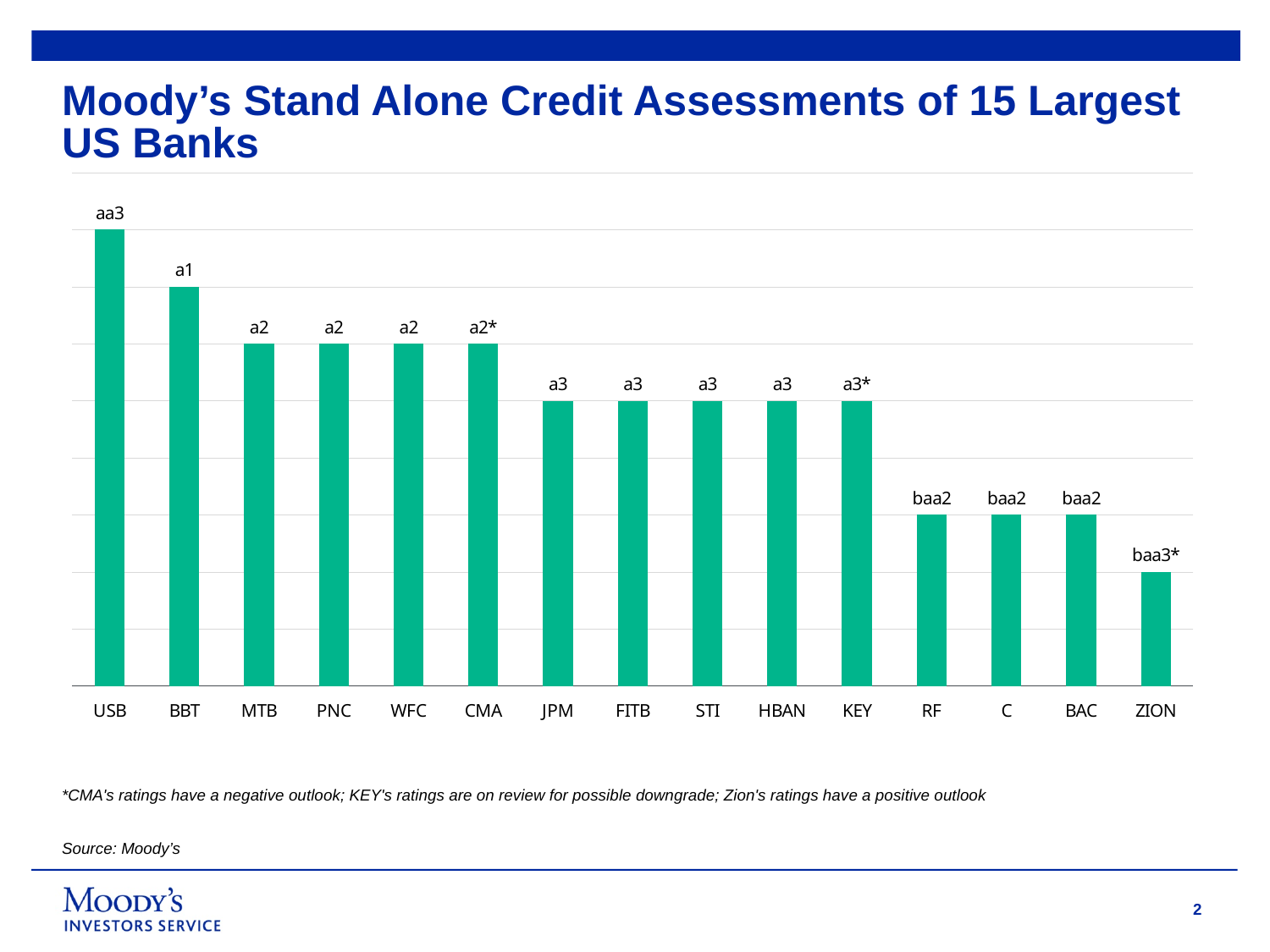
Do the bar heights rise or fall moving from left to right along the x axis? Fall Which bank has the tallest bar in the chart? USB What rating label is shown for ZION? baa3* What rating label is shown for JPM? a3 What is the Moody's stand alone credit assessment shown for USB? aa3 What rating label is shown above the bar for BBT? a1 What rating label is shown for BAC? baa2 What kind of chart is shown on the slide? Bar chart Which bank has a taller bar, MTB or KEY? MTB How many banks are shown on the x axis of the chart? 15 What rating label is shown for CMA? a2* Which bank has the shortest bar in the chart? ZION